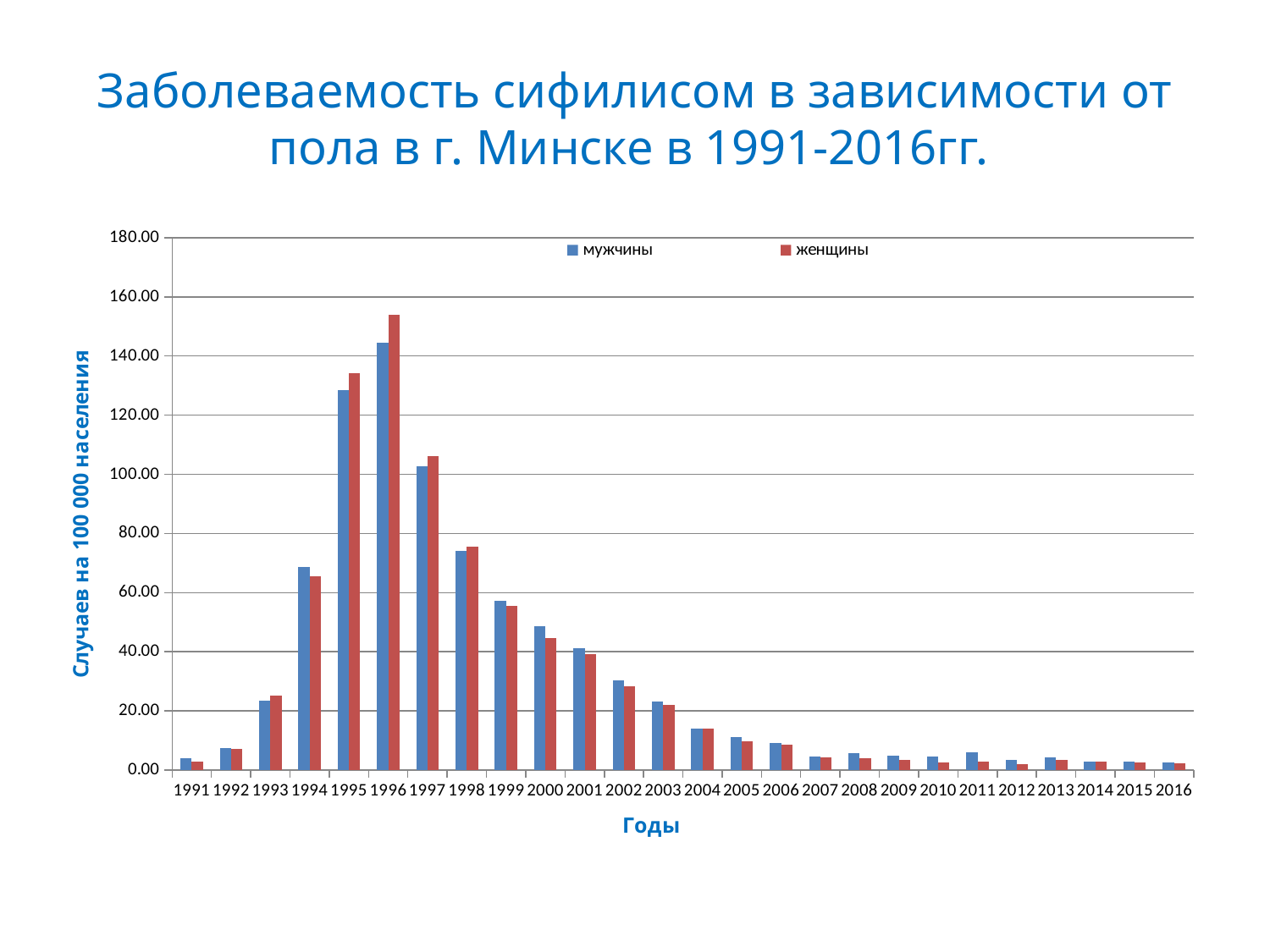
Is the value for мужчины in 1995 greater or less than 120.00? greater What is the title of the vertical axis? Случаев на 100 000 населения What kind of chart is shown on the slide? bar chart In which year is the value for женщины highest? 1996 In which year is the value for мужчины highest? 1996 Do the values for мужчины rise or fall from 1996 to 2016? fall Is the value for женщины in 1996 greater or less than 140.00? greater In 1996, which series has the larger value, мужчины or женщины? женщины Is the value for мужчины in 1998 greater or less than 80.00? less How many series does the legend list? 2 In 2000, which series has the larger value, мужчины or женщины? мужчины How many years are shown along the x axis? 26